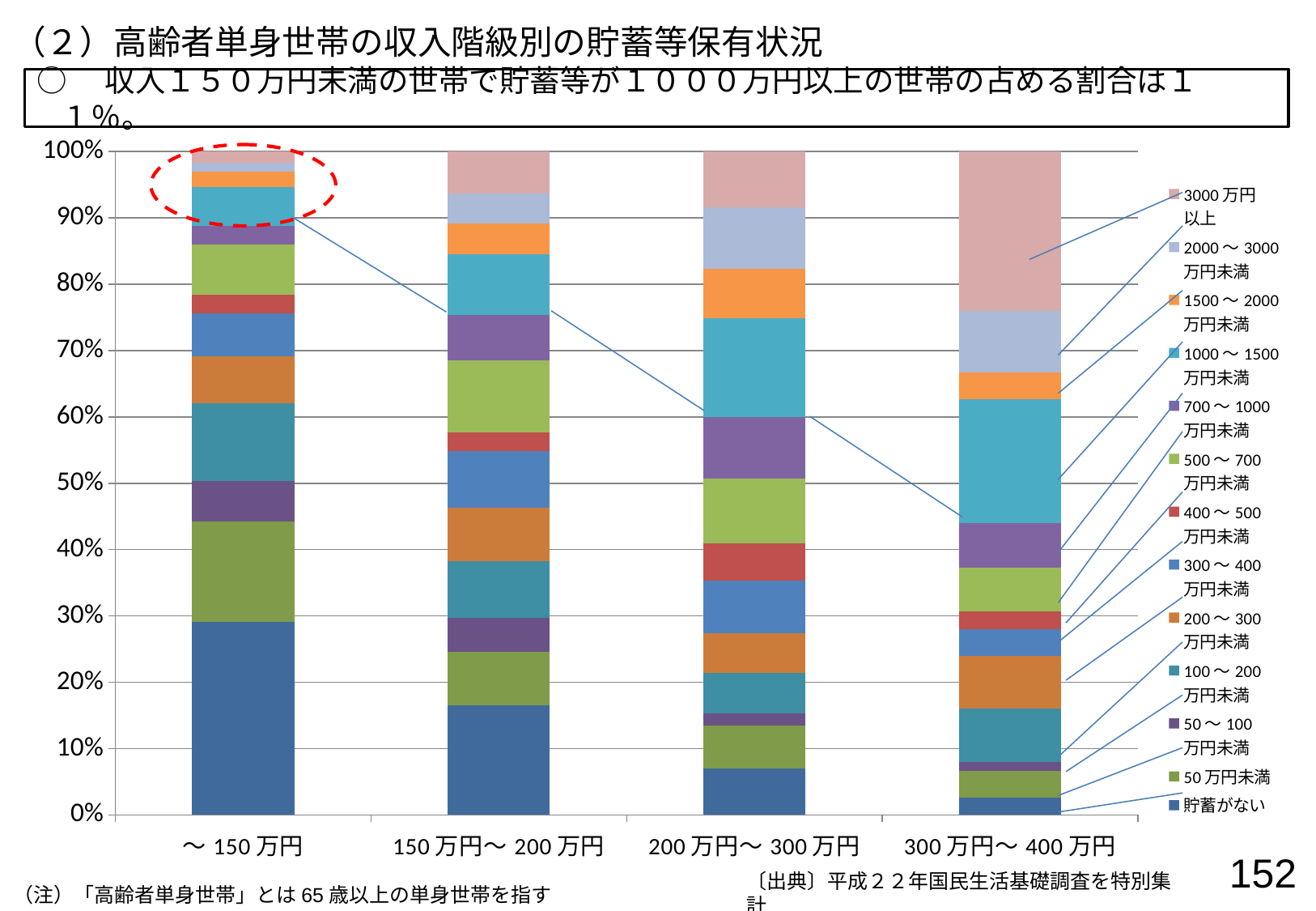
Which income category has the smallest share of 貯蓄がない (no savings)? 300万円～400万円 Is the share of 貯蓄がない in the 300万円～400万円 bar greater or less than 10%? less Which income category has the largest share of 貯蓄がない (no savings)? ～150万円 Which legend entry is listed at the bottom of the chart's legend? 貯蓄がない Which income category has the largest share of 3000万円以上? 300万円～400万円 What kind of chart is shown on the slide? Stacked bar chart According to the slide text, what share of households with income under 150万円 have savings of 1000万円 or more? 11% Is the share of 貯蓄がない in the ～150万円 bar greater or less than 20%? greater How many income categories are shown on the x axis of the chart? 4 Which has a larger share of 貯蓄がない: ～150万円 or 200万円～300万円? ～150万円 How many series does the chart's legend list? 13 How does the share of 貯蓄がない change as income rises from ～150万円 to 300万円～400万円? It falls